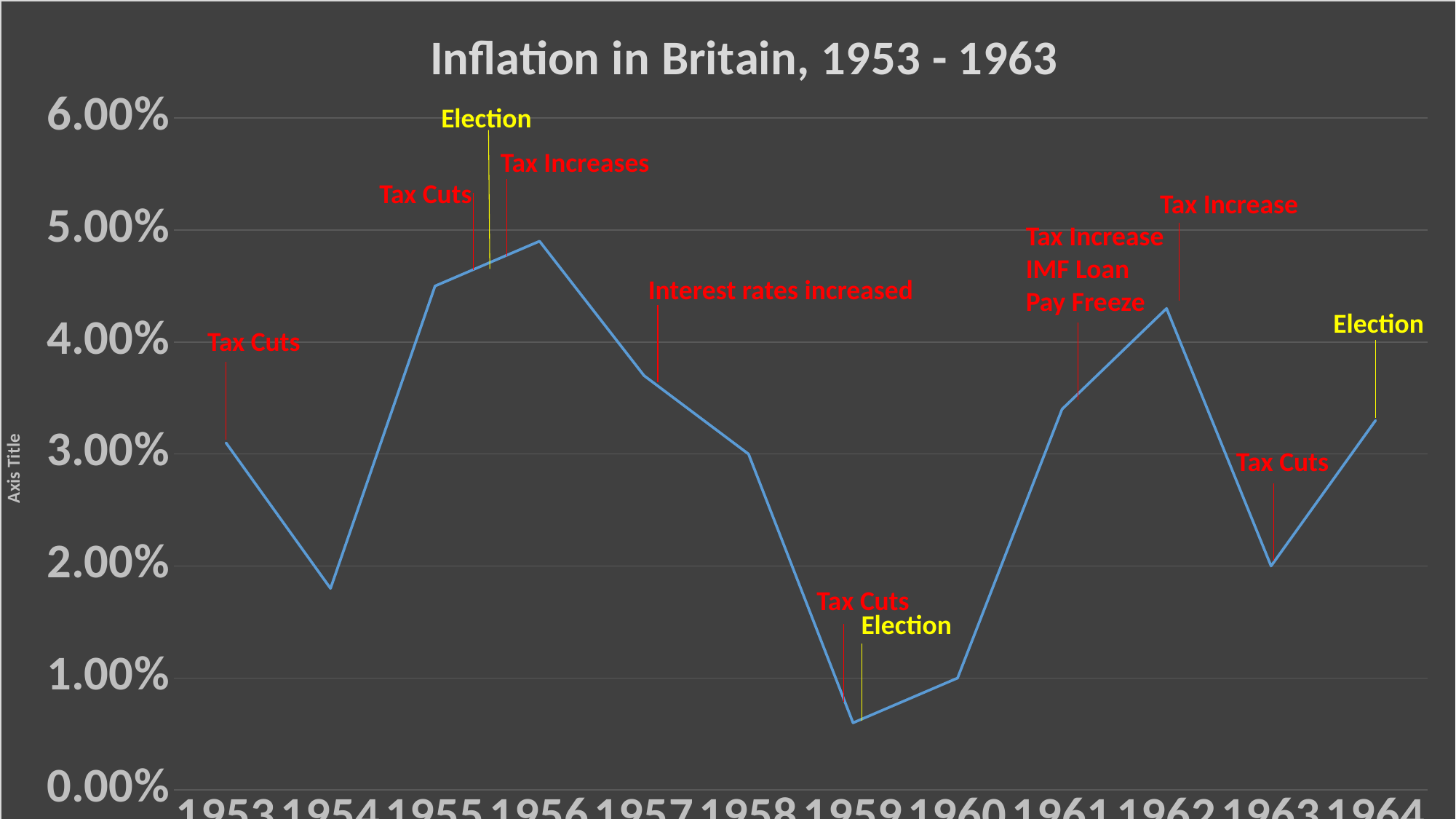
What event is annotated in yellow at the 1964 point? Election Is the value for 1957 greater or less than 3.00%? greater In which year is inflation lowest? 1959 How many years are plotted along the x axis? 12 Does inflation rise or fall from 1956 to 1959? fall Is the value for 1962 greater or less than 4.00%? greater What is the title of the chart? Inflation in Britain, 1953 - 1963 Is the value for 1959 greater or less than 1.00%? less What kind of chart is shown on the slide? line chart In which year is inflation highest? 1956 Which year has higher inflation, 1954 or 1955? 1955